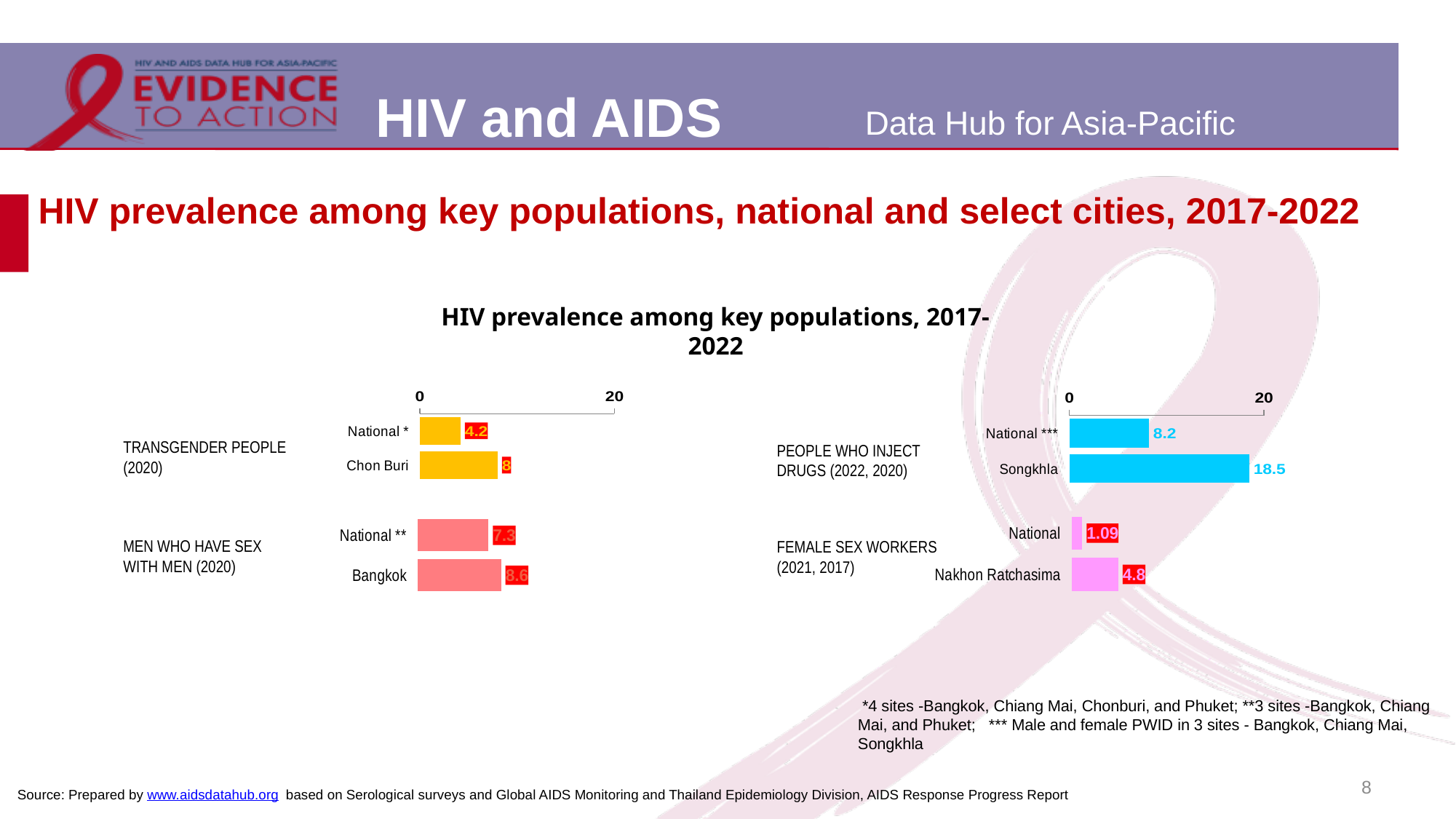
How many key population groups are shown in the chart? 4 What is the difference between the Songkhla and national values for people who inject drugs? 10.3 Which is larger: the Chon Buri value for transgender people or the national value for transgender people? Chon Buri What is the national HIV prevalence value shown for female sex workers? 1.09 What is the difference between the Bangkok and national values for men who have sex with men? 1.3 What is the national HIV prevalence value shown for men who have sex with men? 7.3 What type of chart is used on the slide? Bar chart Which bar in the chart has the highest value? Songkhla (people who inject drugs) Which bar in the chart has the lowest value? National (female sex workers) What is the HIV prevalence value shown for Chon Buri among transgender people? 8 What is the HIV prevalence value shown for Nakhon Ratchasima among female sex workers? 4.8 What is the HIV prevalence value shown for Songkhla among people who inject drugs? 18.5